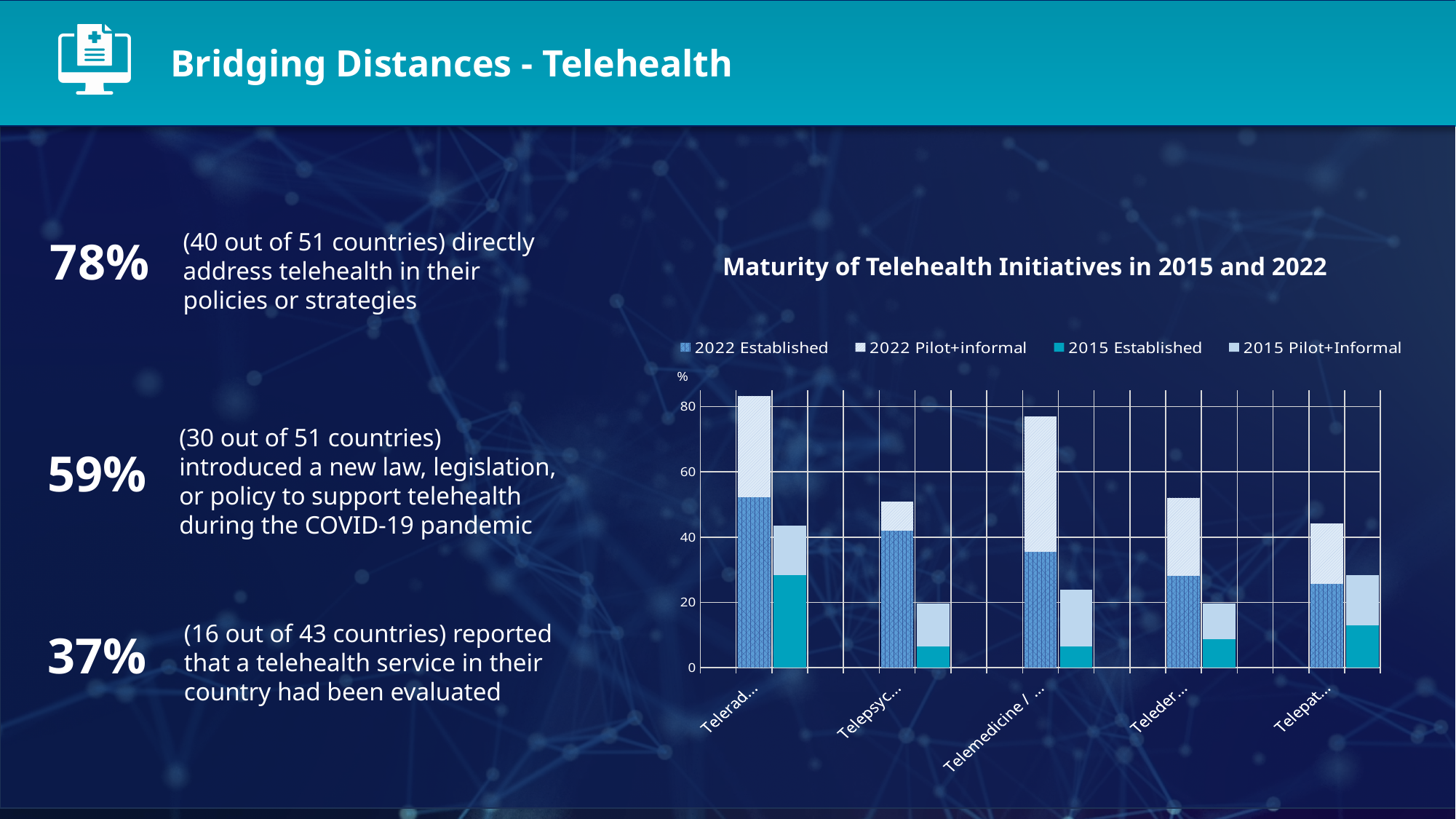
Which category has the tallest 2022 stacked bar? Telerad... (the first category) How many series does the legend of the chart list? 4 Is the 2015 Established value for the second category (Telepsyc...) greater or less than 20? less What kind of chart is shown on the slide? Stacked bar chart Which category has the tallest 2015 stacked bar? Telerad... (the first category) How many categories are plotted along the x axis of the chart? 5 Is the 2022 Established value for the third category (Telemedicine / ...) greater or less than 40? less For the first category (Telerad...), which stacked bar is taller, the 2022 bar or the 2015 bar? 2022 Is the total height of the 2015 stacked bar for the last category (Telepat...) greater or less than 20? greater What is the title of the chart? Maturity of Telehealth Initiatives in 2015 and 2022 What unit is shown on the vertical axis of the chart? %